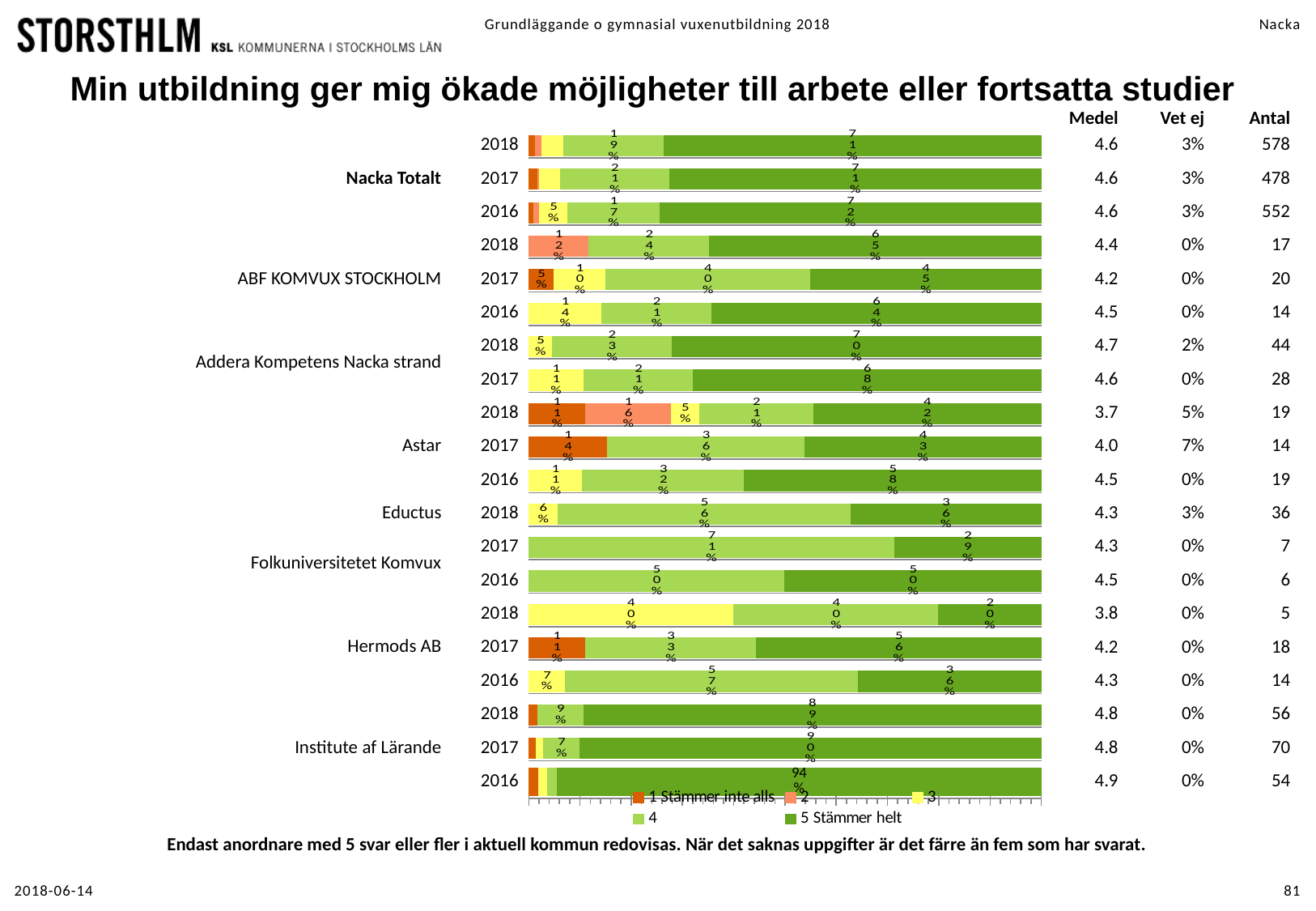
How many series does the chart legend list? 5 What kind of chart is shown on the slide? bar chart What is the value of '5 Stämmer helt' for Nacka Totalt in 2018? 71% Which bar has the highest share of '5 Stämmer helt'? Institute af Lärande 2016 What is the value of '5 Stämmer helt' for Institute af Lärande in 2016? 94% What is the value of '3' for Hermods AB in 2018? 40% Which bar has the lowest share of '5 Stämmer helt'? Hermods AB 2018 What is the first entry in the chart legend? 1 Stämmer inte alls For Folkuniversitetet Komvux in 2017, what is the difference between the share for '4' and the share for '5 Stämmer helt'? 42 percentage points What is the value of '1 Stämmer inte alls' for ABF KOMVUX STOCKHOLM in 2017? 5% What is the value of '2' for Astar in 2018? 16% For Eductus in 2018, which is larger: the share for '4' or the share for '5 Stämmer helt'? 4